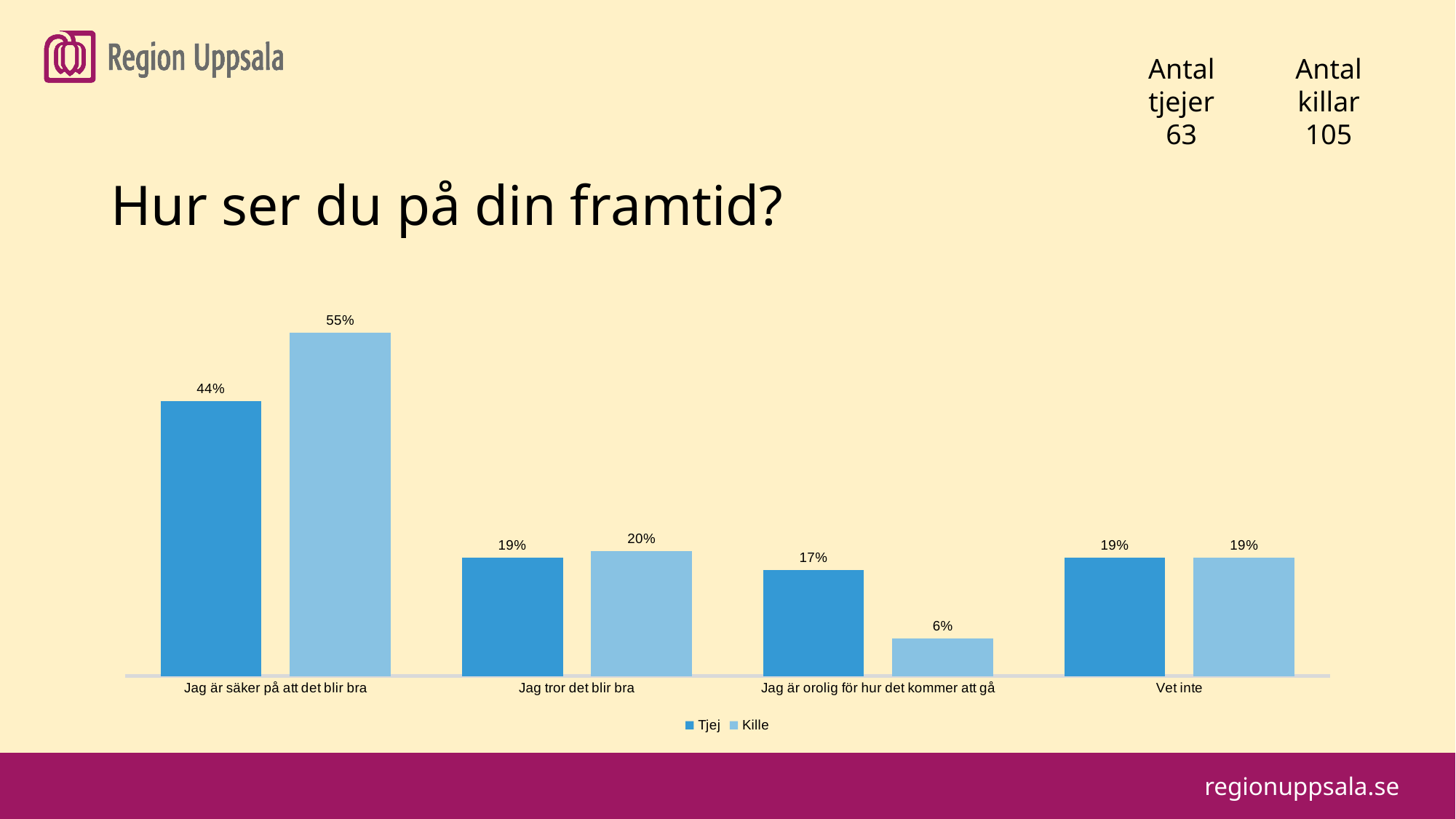
What is the value for Tjej in the category "Vet inte"? 19% What is the difference between the Kille and Tjej values in the category "Jag är säker på att det blir bra"? 11% In the category "Jag är orolig för hur det kommer att gå", which series has the larger value, Tjej or Kille? Tjej What kind of chart is shown on the slide? Bar chart What is the difference between the Tjej and Kille values in the category "Jag är orolig för hur det kommer att gå"? 11% What is the value for Kille in the category "Jag är orolig för hur det kommer att gå"? 6% Which category has the highest value for the Kille series? Jag är säker på att det blir bra How many categories are shown on the x axis of the chart? 4 What is the value for Kille in the category "Jag är säker på att det blir bra"? 55% What is the value for Tjej in the category "Jag är säker på att det blir bra"? 44% How many series does the legend list? 2 Which category has the lowest value for the Kille series? Jag är orolig för hur det kommer att gå